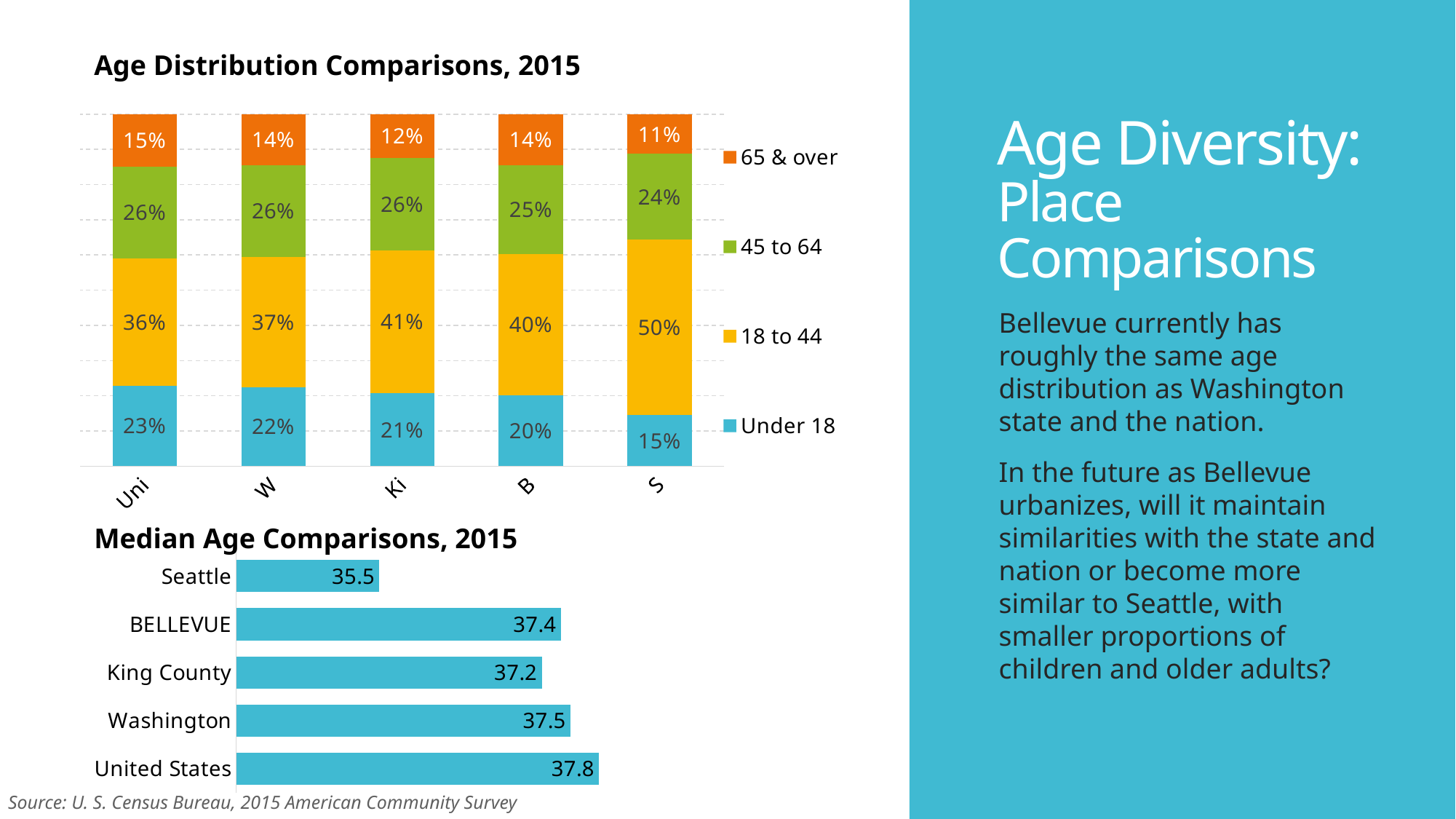
What kind of chart is the 'Median Age Comparisons, 2015' chart? Bar chart In the 'Age Distribution Comparisons, 2015' chart, which colour represents the '45 to 64' series? Green In the 'Median Age Comparisons, 2015' chart, which place has the lowest median age? Seattle In the 'Median Age Comparisons, 2015' chart, which place has the highest median age? United States In the 'Age Distribution Comparisons, 2015' chart, what is the 'Under 18' share for the bar labelled 'Uni'? 23% In the 'Median Age Comparisons, 2015' chart, how many places are shown? 5 In the 'Median Age Comparisons, 2015' chart, what is the median age for Seattle? 35.5 In the 'Age Distribution Comparisons, 2015' chart, which bar has the smallest '65 & over' share? S In the 'Age Distribution Comparisons, 2015' chart, what is the '18 to 44' share for the bar labelled 'S'? 50% In the 'Median Age Comparisons, 2015' chart, what is the median age for BELLEVUE? 37.4 In the 'Median Age Comparisons, 2015' chart, what is the difference between the median age of the United States and that of Seattle? 2.3 In the 'Age Distribution Comparisons, 2015' chart, how many series does the legend list? 4